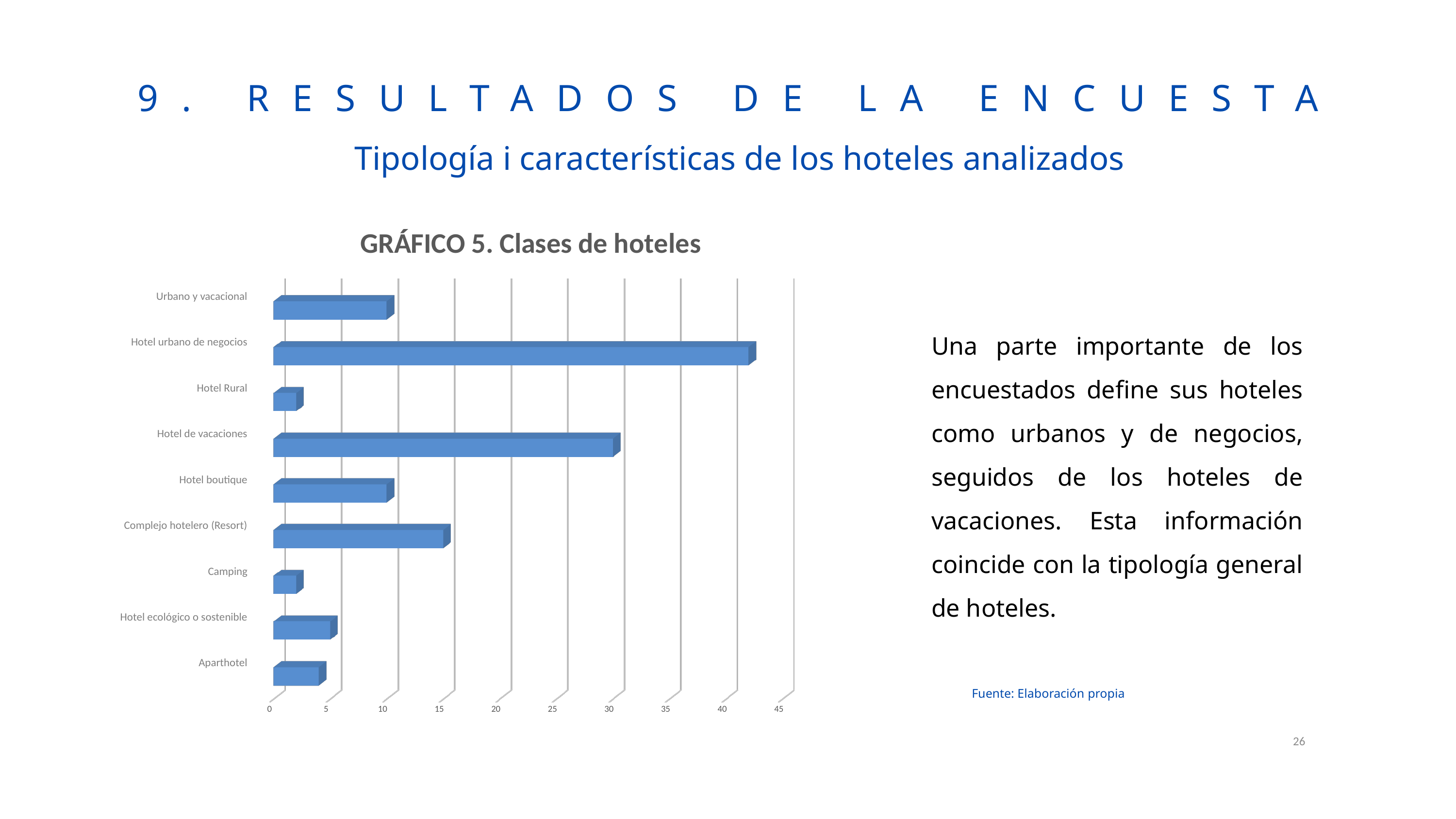
Which is larger, the value for Hotel urbano de negocios or the value for Hotel de vacaciones? Hotel urbano de negocios Is the value for Hotel Rural greater or less than 5? less Which hotel category has the highest value in the chart? Hotel urbano de negocios Which is larger, the value for Hotel de vacaciones or the value for Complejo hotelero (Resort)? Hotel de vacaciones Is the value for Complejo hotelero (Resort) greater or less than 10? greater How many hotel categories are plotted in the chart? 9 What is the title of the chart? GRÁFICO 5. Clases de hoteles Is the value for Hotel urbano de negocios greater or less than 35? greater What source is cited for the chart? Fuente: Elaboración propia What kind of chart is shown on the slide? Bar chart